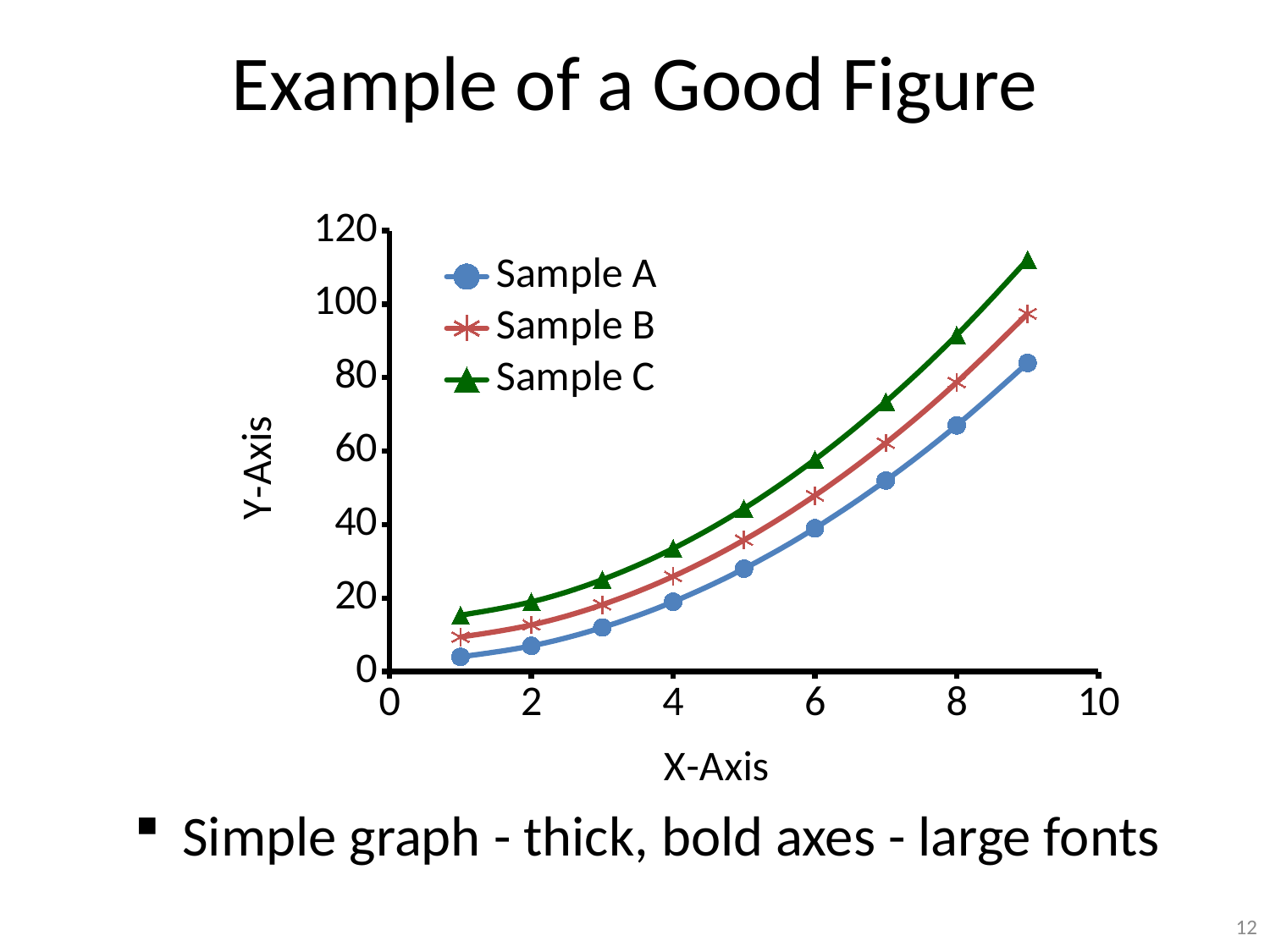
At x = 1, is the value for Sample A greater or less than 20? less What is the title of the vertical axis? Y-Axis Which series has the highest value at x = 9? Sample C How many series does the legend list? 3 Which series has the lowest value at x = 9? Sample A At x = 7, is the value for Sample C greater or less than 60? greater How many data points are plotted for Sample A? 9 What kind of chart is shown on the slide? line chart At x = 5, which is larger: the value for Sample B or the value for Sample A? Sample B Do the values for Sample C rise or fall as the x value increases? rise At x = 9, is the value for Sample C greater or less than 100? greater